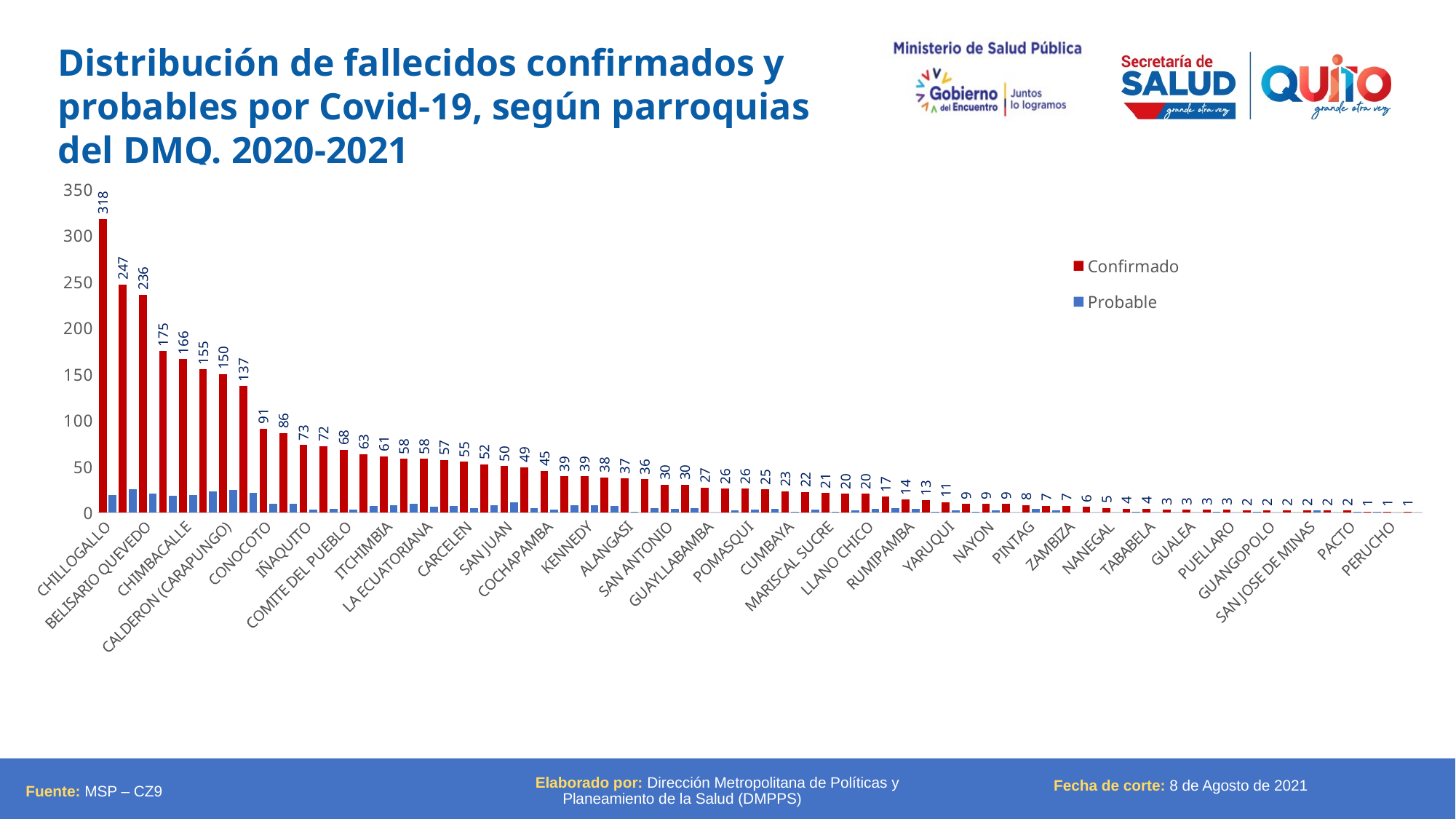
Which parish has the highest number of confirmed deaths? CHILLOGALLO What is the difference in confirmed deaths between CHILLOGALLO (318) and CONOCOTO (91)? 227 Which colour represents the 'Confirmado' series in the legend? red What is the confirmed death count for CHILLOGALLO? 318 How many series does the legend list? 2 Is the confirmed value for CHILLOGALLO greater or less than 300? greater What is the confirmed death count for CONOCOTO? 91 Which has more confirmed deaths, CHILLOGALLO or CHIMBACALLE? CHILLOGALLO What is the name of the second series listed in the legend? Probable What is the confirmed death count for PERUCHO? 1 Do the confirmed death values rise or fall moving from left to right along the x axis? fall What type of chart is shown on the slide? bar chart